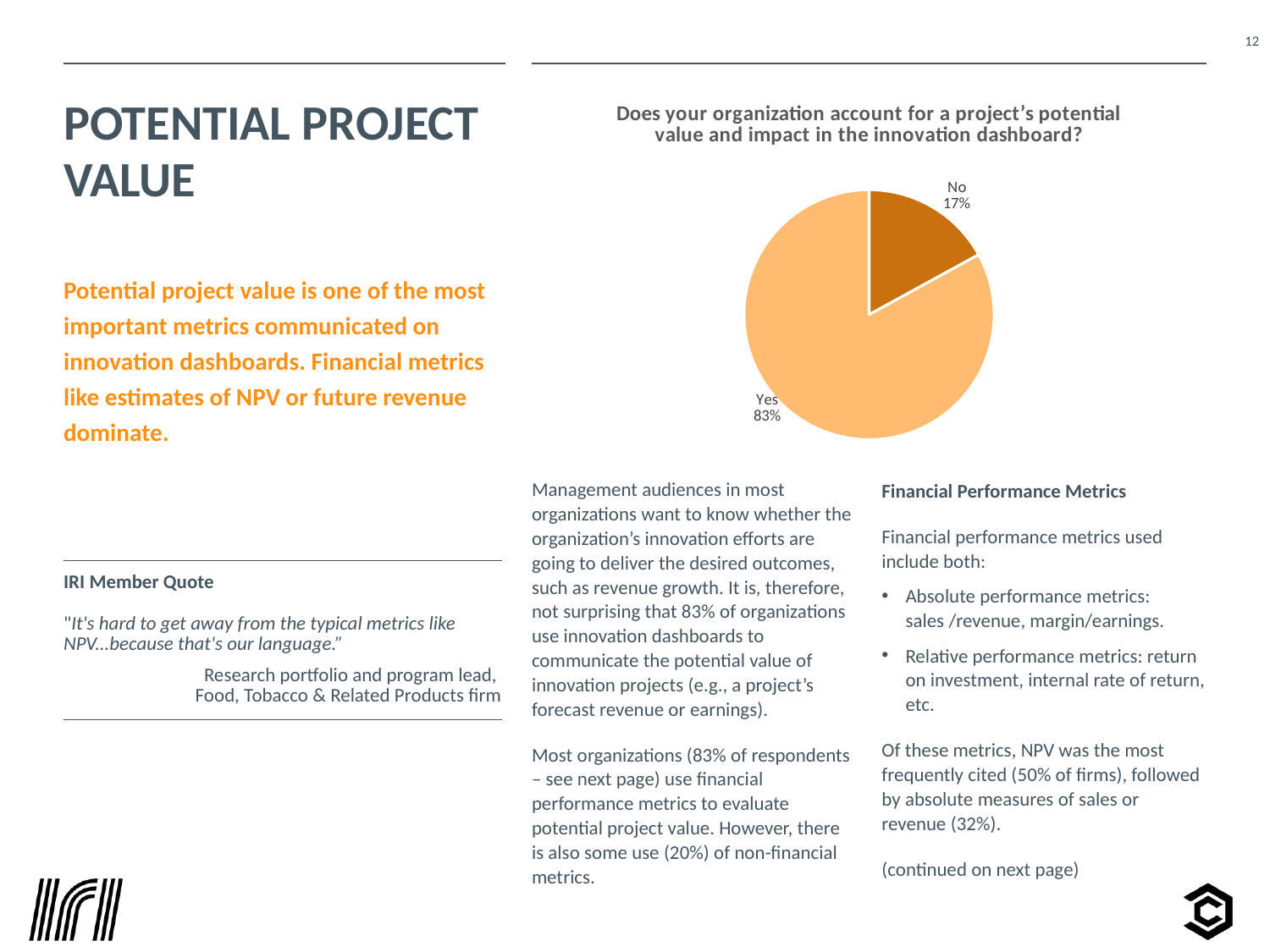
What percentage of respondents answered "Yes" in the pie chart? 83% What is the difference in percentage points between the "Yes" and "No" slices? 66 Which slice of the pie chart is the smallest? No What is the title of the pie chart? Does your organization account for a project's potential value and impact in the innovation dashboard? What share of the pie does the "No" slice represent? 17% Which is larger in the pie chart, the "Yes" slice or the "No" slice? Yes Which slice of the pie chart is shown in the darker orange colour? No What kind of chart is shown on the slide? pie chart What percentage of respondents answered "No" in the pie chart? 17% Is the value for "Yes" greater or less than 50%? greater Which slice of the pie chart is the largest? Yes How many slices does the pie chart have? 2